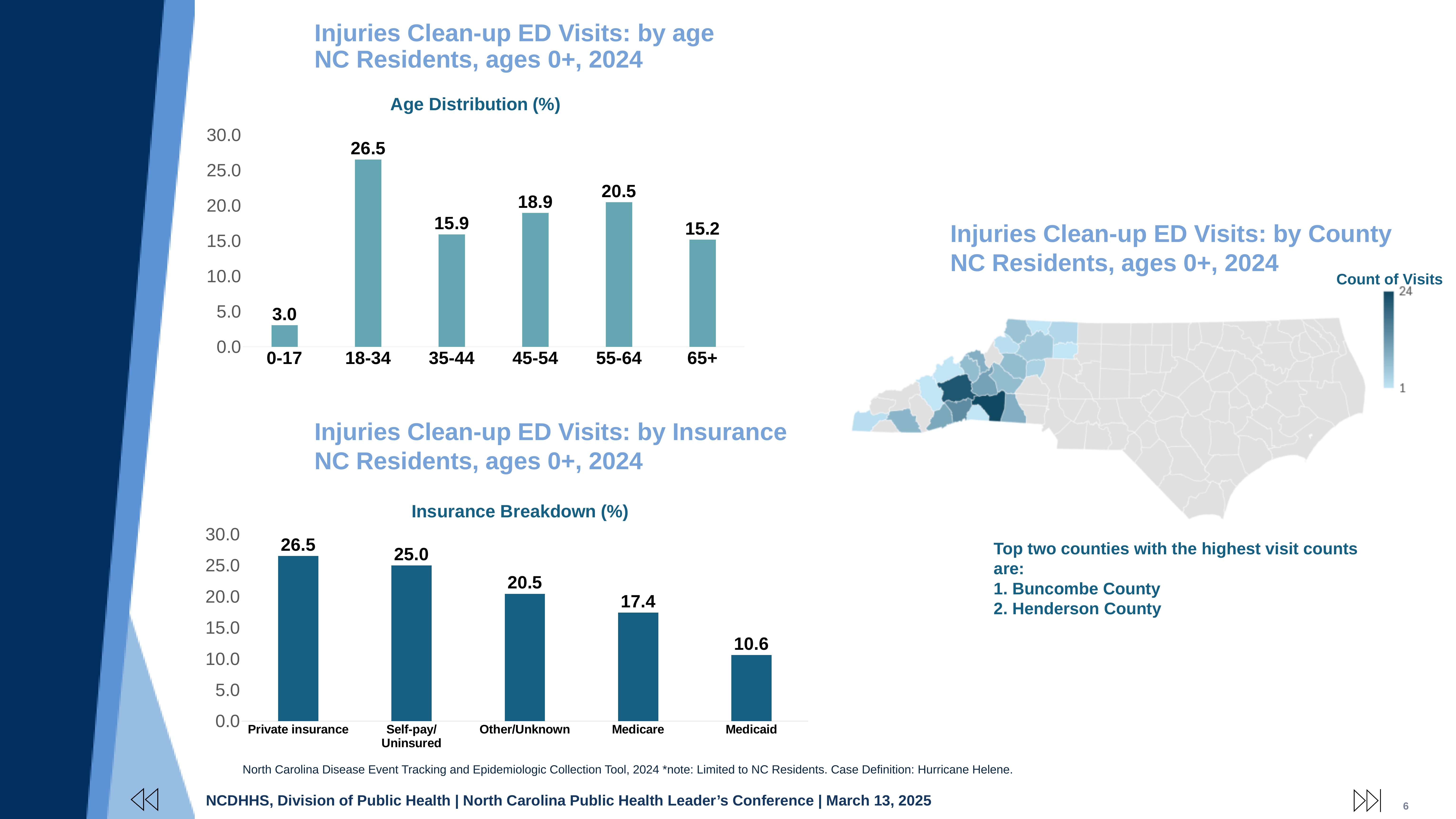
In the Insurance Breakdown (%) chart, do the values rise or fall from left to right? Fall In the Age Distribution (%) chart, which is larger, the value for 45-54 or the value for 65+? 45-54 In the Insurance Breakdown (%) chart, which category has the lowest value? Medicaid In the Insurance Breakdown (%) chart, what is the value for Medicare? 17.4 In the Insurance Breakdown (%) chart, how many insurance categories are shown? 5 In the Insurance Breakdown (%) chart, what is the difference between Private insurance and Self-pay/Uninsured? 1.5 In the Age Distribution (%) chart, which age group has the highest value? 18-34 In the Age Distribution (%) chart, which age group has the lowest value? 0-17 In the Age Distribution (%) chart, how many age groups are shown? 6 In the Age Distribution (%) chart, what is the difference between the values for 55-64 and 35-44? 4.6 What kind of chart is the Insurance Breakdown (%) chart? Bar chart In the Age Distribution (%) chart, what is the value for the 18-34 age group? 26.5